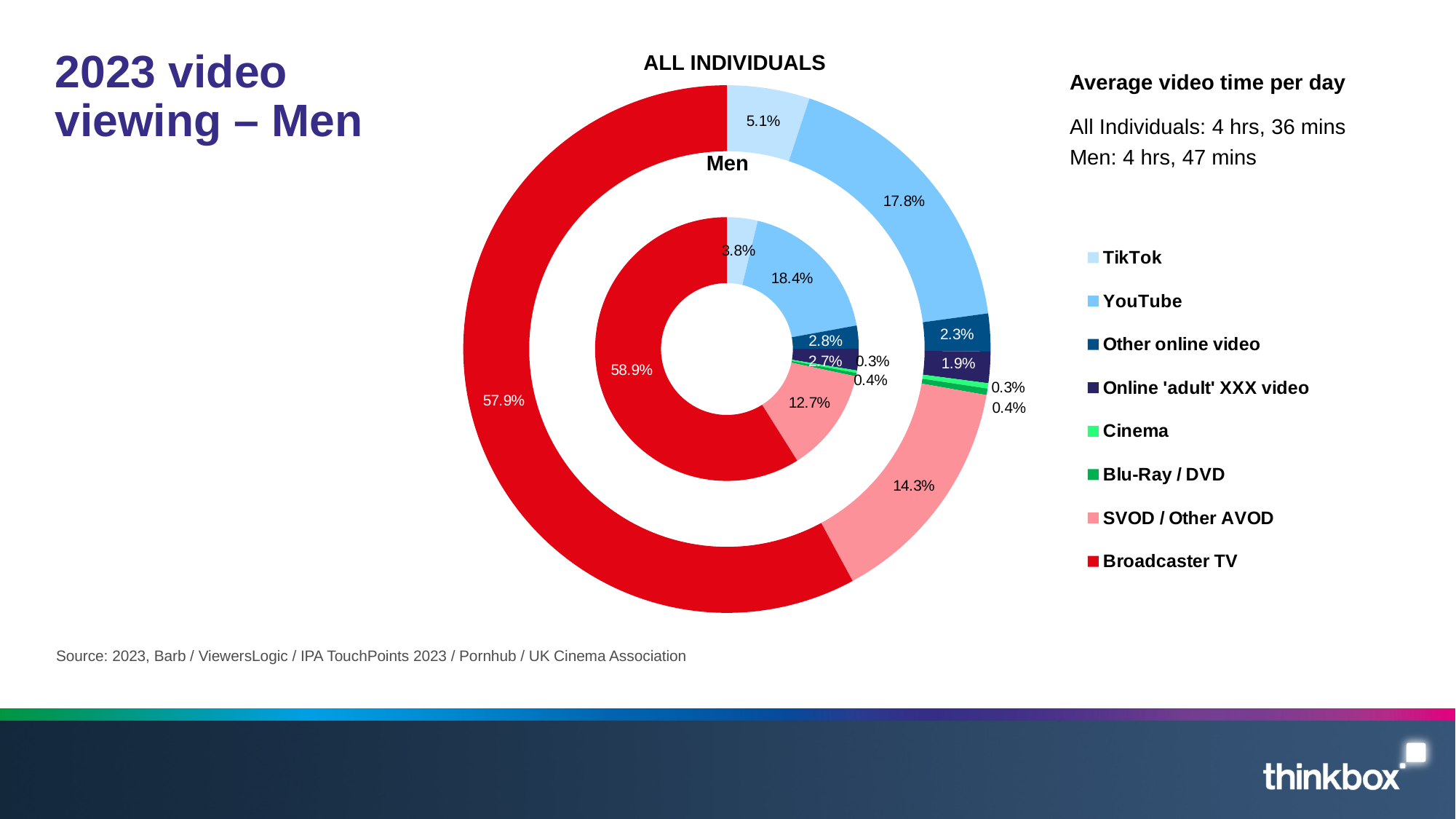
What is the share of TikTok in the All Individuals ring? 5.1% What is the difference between the Broadcaster TV share for Men and for All Individuals? 1.0% According to the slide, what is the average video time per day for Men? 4 hrs, 47 mins Which category has the largest share in the Men ring? Broadcaster TV Which is larger in the All Individuals ring: YouTube or SVOD / Other AVOD? YouTube What type of chart is shown on the slide? Doughnut chart What is the share of Broadcaster TV in the Men ring? 58.9% What is the share of YouTube in the Men ring? 18.4% What is the share of SVOD / Other AVOD in the Men ring? 12.7% What is the share of Broadcaster TV in the All Individuals ring? 57.9% How many categories does the legend list? 8 What is the difference between the YouTube share for Men and for All Individuals? 0.6%